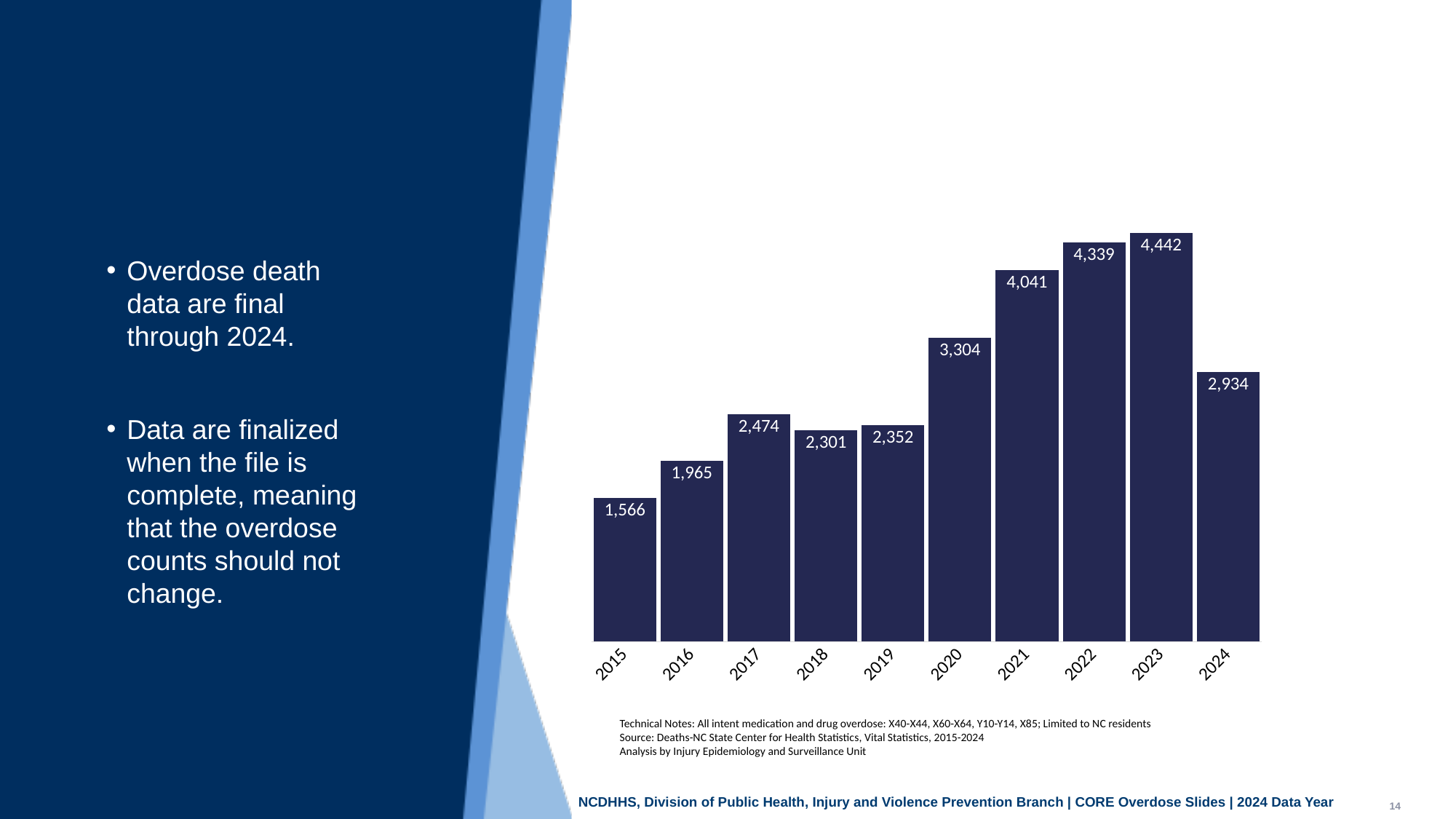
Which year has the highest value? 2023 What is the value for 2020? 3,304 Which is larger, the value for 2017 or the value for 2018? 2017 Do the values rise or fall from 2019 to 2023? Rise What is the value for 2015? 1,566 What kind of chart is shown on the slide? Bar chart Which year has the lowest value? 2015 Which is larger, the value for 2024 or the value for 2020? 2020 What is the value for 2024? 2,934 What is the difference between the values for 2020 and 2019? 952 What is the difference between the values for 2023 and 2024? 1,508 How many years are shown on the x axis? 10